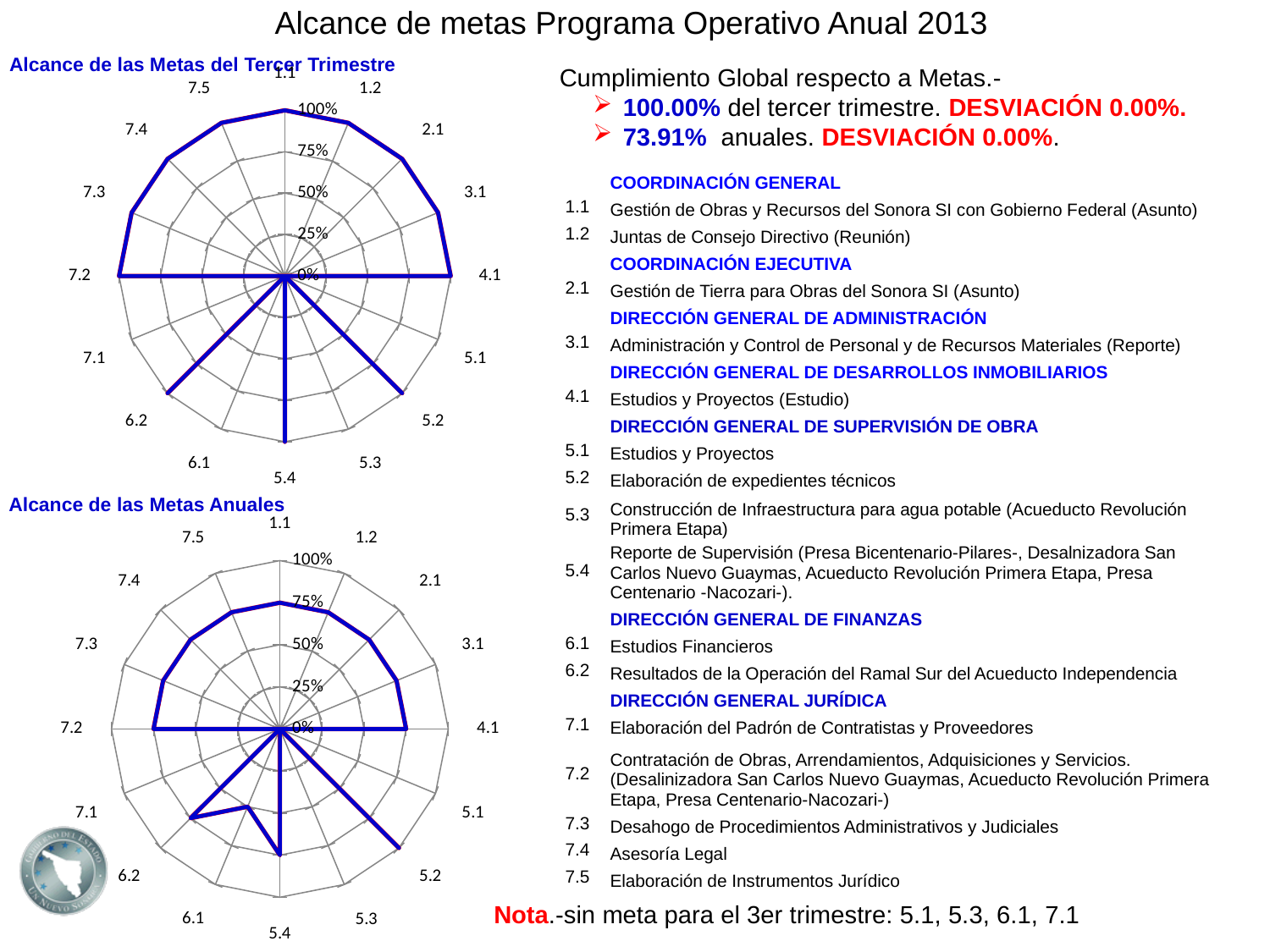
In the 'Alcance de las Metas Anuales' chart, what is the value for category 7.1? 0% How many categories are plotted on the 'Alcance de las Metas del Tercer Trimestre' chart? 16 In the 'Alcance de las Metas del Tercer Trimestre' chart, what is the value for category 5.1? 0% In the 'Alcance de las Metas del Tercer Trimestre' chart, what is the difference between the values for 1.1 and 7.1? 100% In the 'Alcance de las Metas Anuales' chart, is the value for 5.2 greater or less than 50%? greater In the 'Alcance de las Metas del Tercer Trimestre' chart, which is larger, the value for 4.1 or the value for 5.3? 4.1 In the 'Alcance de las Metas del Tercer Trimestre' chart, what is the value for category 7.2? 100% In the 'Alcance de las Metas Anuales' chart, is the value for 6.1 greater or less than 75%? less What is the title of the bottom chart on the slide? Alcance de las Metas Anuales What kind of chart is the top chart, 'Alcance de las Metas del Tercer Trimestre'? Radar chart What is the highest percentage tick shown on the axis of the 'Alcance de las Metas Anuales' chart? 100% In the 'Alcance de las Metas Anuales' chart, which is larger, the value for 4.1 or the value for 6.1? 4.1